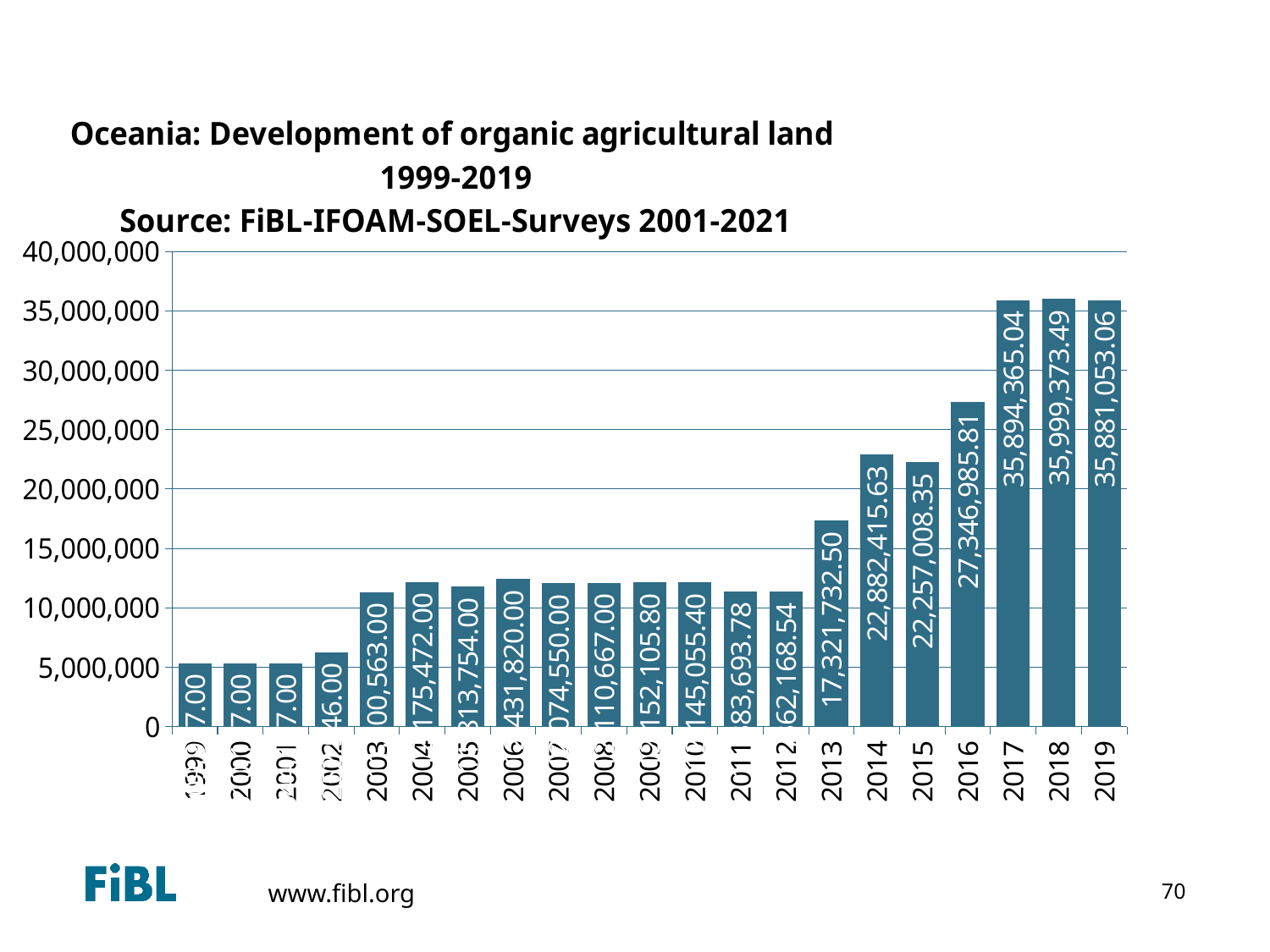
Is the value for 2003 greater or less than 10,000,000? greater What is the difference between the values for 2016 and 2015? 5,089,977.46 Which year has the larger value, 2014 or 2015? 2014 What kind of chart is shown on the slide? bar chart What is the value for 2014? 22,882,415.63 What is the value for 2019? 35,881,053.06 How many years are shown on the x axis? 21 Is the value for 2002 greater or less than 10,000,000? less Do the values rise or fall from 2013 to 2016? rise What is the difference between the values for 2017 and 2016? 8,547,379.23 What is the value for 2013? 17,321,732.50 What is the value for 2016? 27,346,985.81